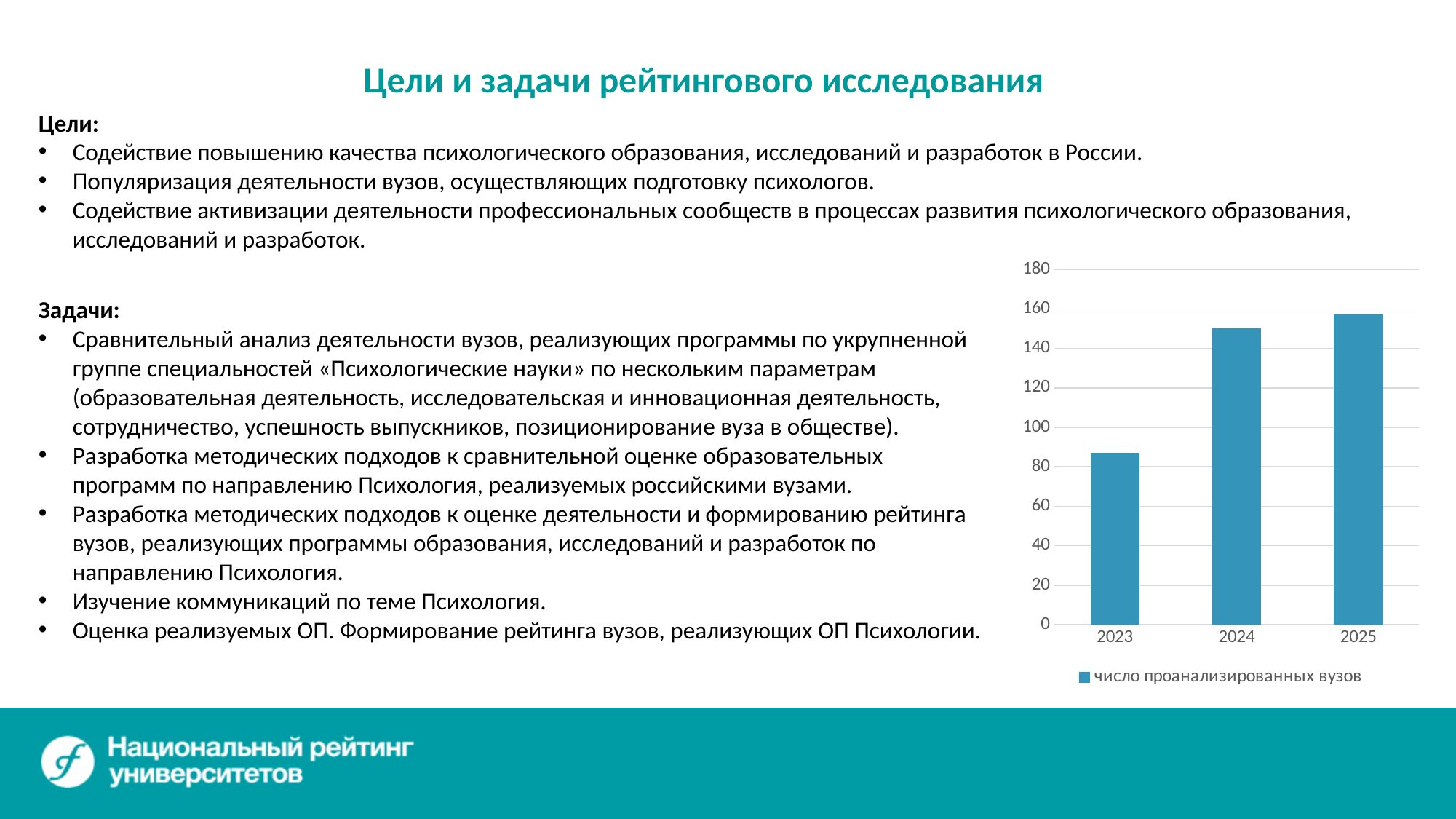
Which is larger, the value for 2023 or the value for 2024? 2024 Is the value for 2023 greater or less than 100? less What kind of chart is shown on the slide? bar chart What is the highest value shown on the chart's vertical axis? 180 Which year has the lowest value in the chart? 2023 How many years are shown on the x axis of the chart? 3 How many series does the chart legend list? 1 Do the values in the chart rise or fall from 2023 to 2025? rise Is the value for 2025 greater or less than 160? less Is the value for 2024 greater or less than 140? greater Which year has the highest value in the chart? 2025 What is the series name shown in the chart legend? число проанализированных вузов